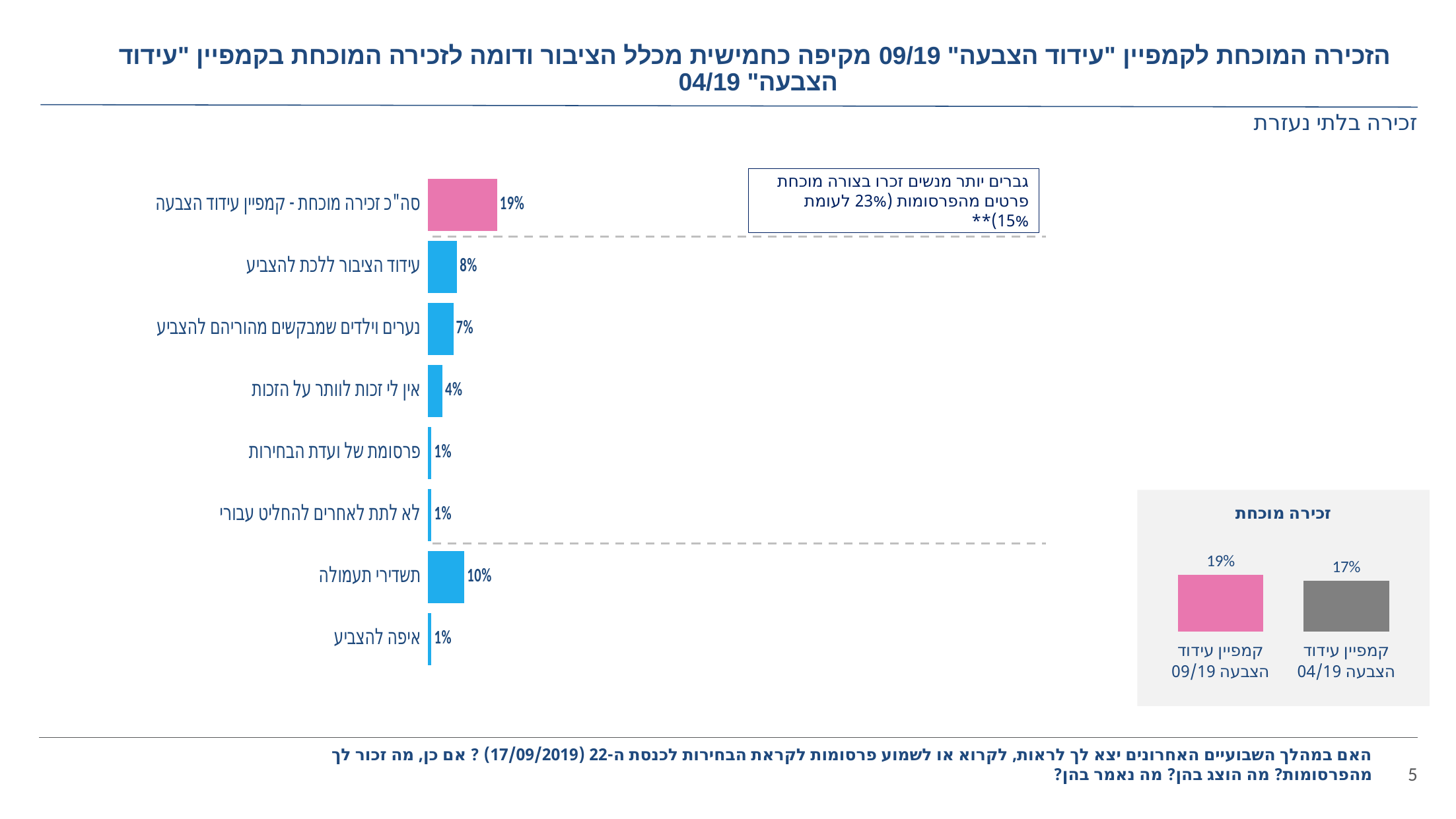
In the small chart on the right titled "זכירה מוכחת", what colour is the bar for "קמפיין עידוד הצבעה 09/19"? Pink In the main bar chart on the left, what is the value for "עידוד הציבור ללכת להצביע"? 8% In the main bar chart on the left, what is the value for "תשדירי תעמולה"? 10% In the main bar chart on the left, what is the value for "אין לי זכות לוותר על הזכות"? 4% In the main bar chart on the left, which is larger: "עידוד הציבור ללכת להצביע" or "נערים וילדים שמבקשים מהוריהם להצביע"? עידוד הציבור ללכת להצביע What type of chart is the main chart on the left? Bar chart In the main bar chart on the left, how many categories have a value of 1%? 3 How many categories are shown in the main bar chart on the left? 8 In the small chart on the right titled "זכירה מוכחת", what is the value for "קמפיין עידוד הצבעה 04/19"? 17% In the small chart on the right titled "זכירה מוכחת", what is the difference between "קמפיין עידוד הצבעה 09/19" and "קמפיין עידוד הצבעה 04/19"? 2% In the main bar chart on the left, what is the difference between "תשדירי תעמולה" and "נערים וילדים שמבקשים מהוריהם להצביע"? 3% In the main bar chart on the left, which category has the highest value? סה"כ זכירה מוכחת - קמפיין עידוד הצבעה